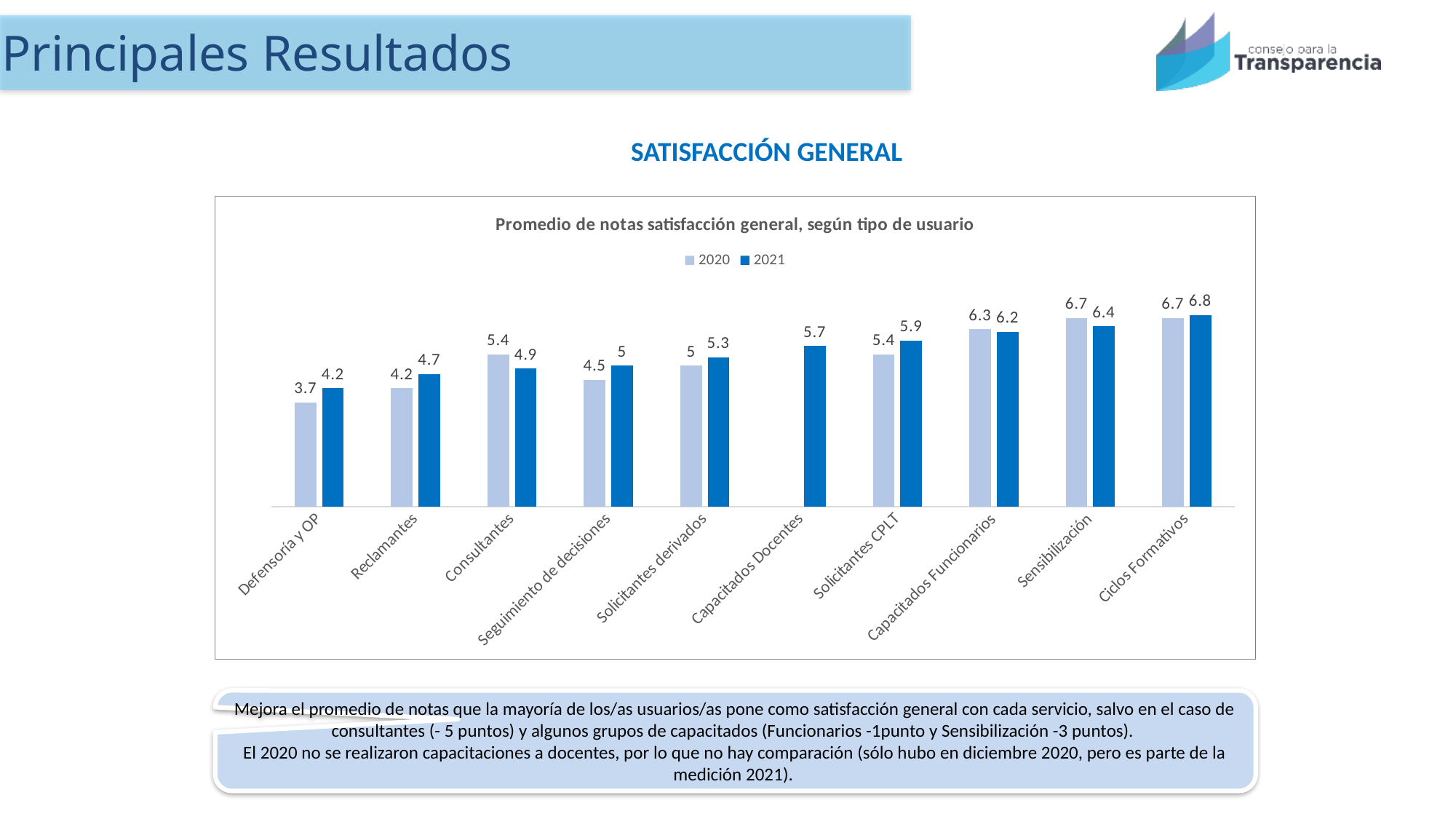
For Sensibilización, which is larger: the 2020 value or the 2021 value? 2020 How many categories are shown on the x axis? 10 Which category has no 2020 bar? Capacitados Docentes Which category has the highest 2021 value? Ciclos Formativos Which category has the lowest 2020 value? Defensoría y OP How many series does the legend list? 2 What is the title of the chart? Promedio de notas satisfacción general, según tipo de usuario What is the 2021 value for Capacitados Docentes? 5.7 What is the 2020 value for Consultantes? 5.4 What is the difference between the 2021 and 2020 values for Reclamantes? 0.5 What kind of chart is shown? Bar chart What is the 2021 value for Solicitantes CPLT? 5.9